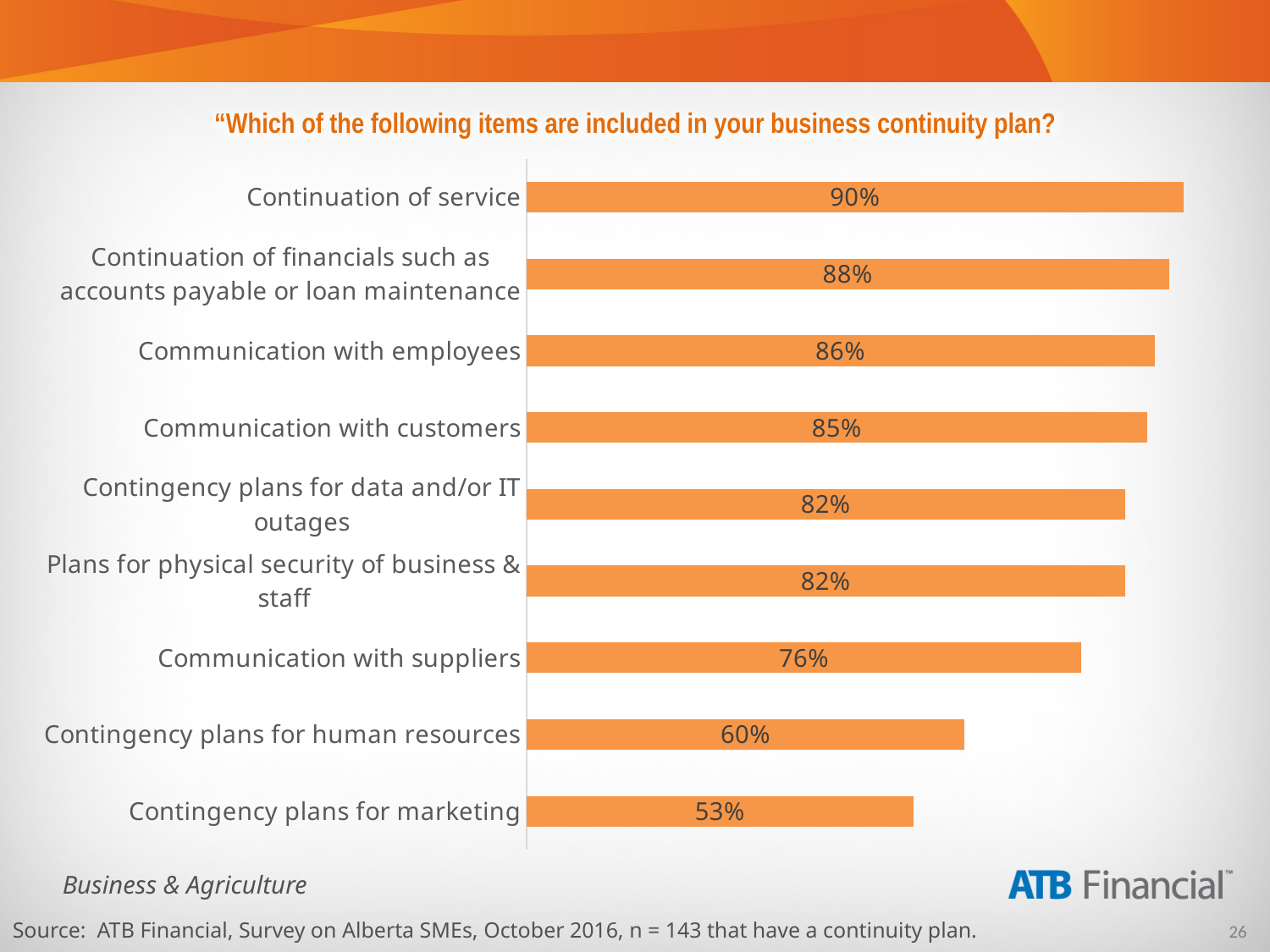
What is the title of the chart? "Which of the following items are included in your business continuity plan? What is the value for contingency plans for human resources? 60% What kind of chart is shown on the slide? Bar chart What is the value for communication with suppliers? 76% Which item has the highest percentage? Continuation of service Which is larger: the value for communication with customers or the value for communication with suppliers? Communication with customers Which item has the lowest percentage? Contingency plans for marketing What is the difference between communication with employees and contingency plans for human resources? 26% Which two items share the same value of 82%? Contingency plans for data and/or IT outages; Plans for physical security of business & staff What percentage of respondents include continuation of service in their business continuity plan? 90% How many items are shown in the chart? 9 What is the difference between the values for continuation of service and contingency plans for marketing? 37%